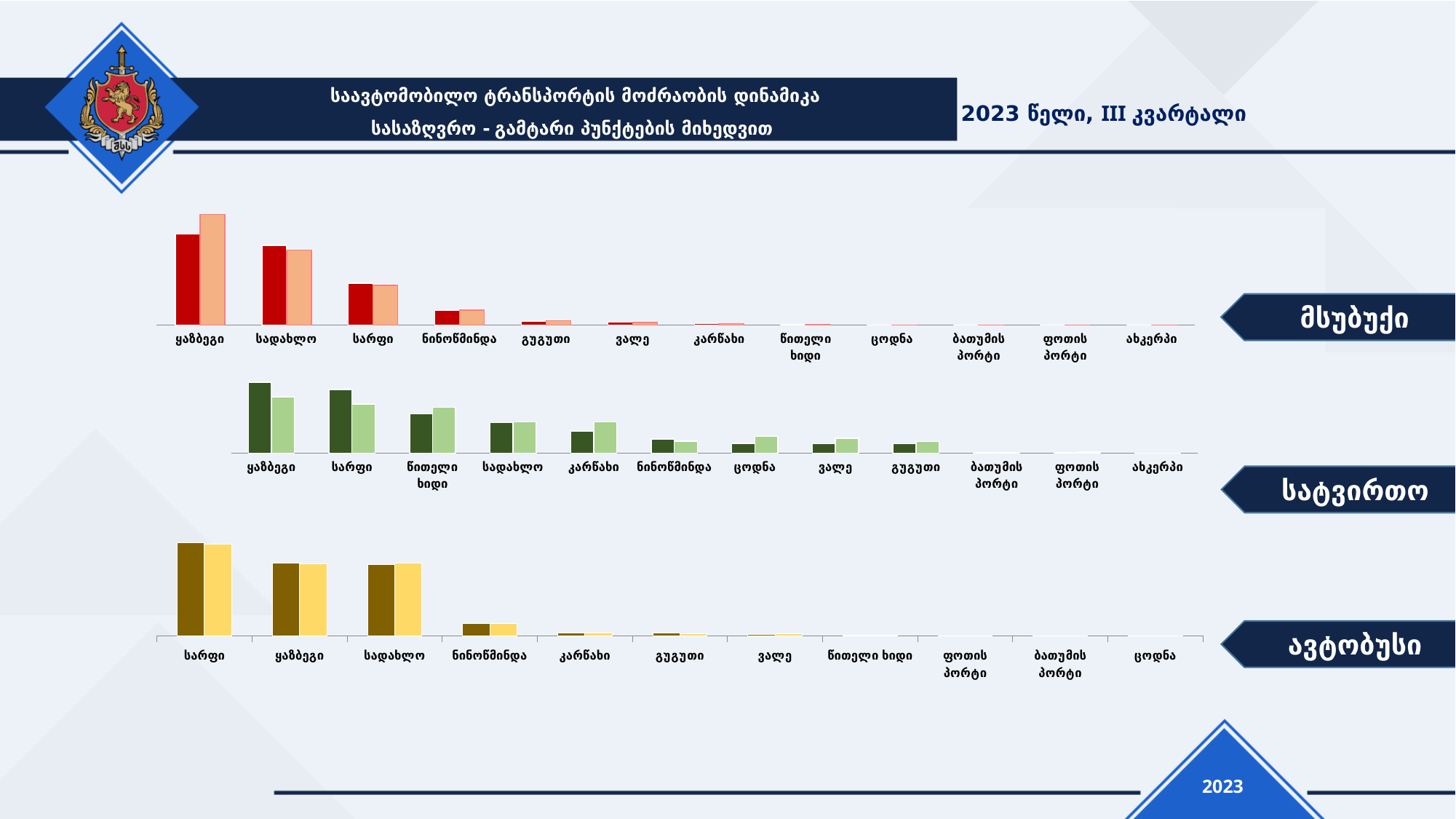
How many categories are shown on the x axis of the ავტობუსი chart? 11 In the ავტობუსი chart, which category has larger bars, სარფი or ნინოწმინდა? სარფი In the ავტობუსი chart, which category has the highest bars? სარფი In the სატვირთო chart, do the bar heights generally rise or fall from left to right along the x axis? fall How many categories are shown on the x axis of the მსუბუქი chart? 12 In the მსუბუქი chart, which category has the highest bars? ყაზბეგი In the სატვირთო chart, which category has larger bars, ყაზბეგი or გუგუთი? ყაზბეგი What kind of chart is the მსუბუქი chart at the top of the slide? bar chart How many bars are drawn for each category in the ავტობუსი chart? 2 In the მსუბუქი chart, which category has larger bars, ყაზბეგი or სარფი? ყაზბეგი In the სატვირთო chart, which category has the tallest bar? ყაზბეგი What colours are the bars in the სატვირთო chart? dark green and light green